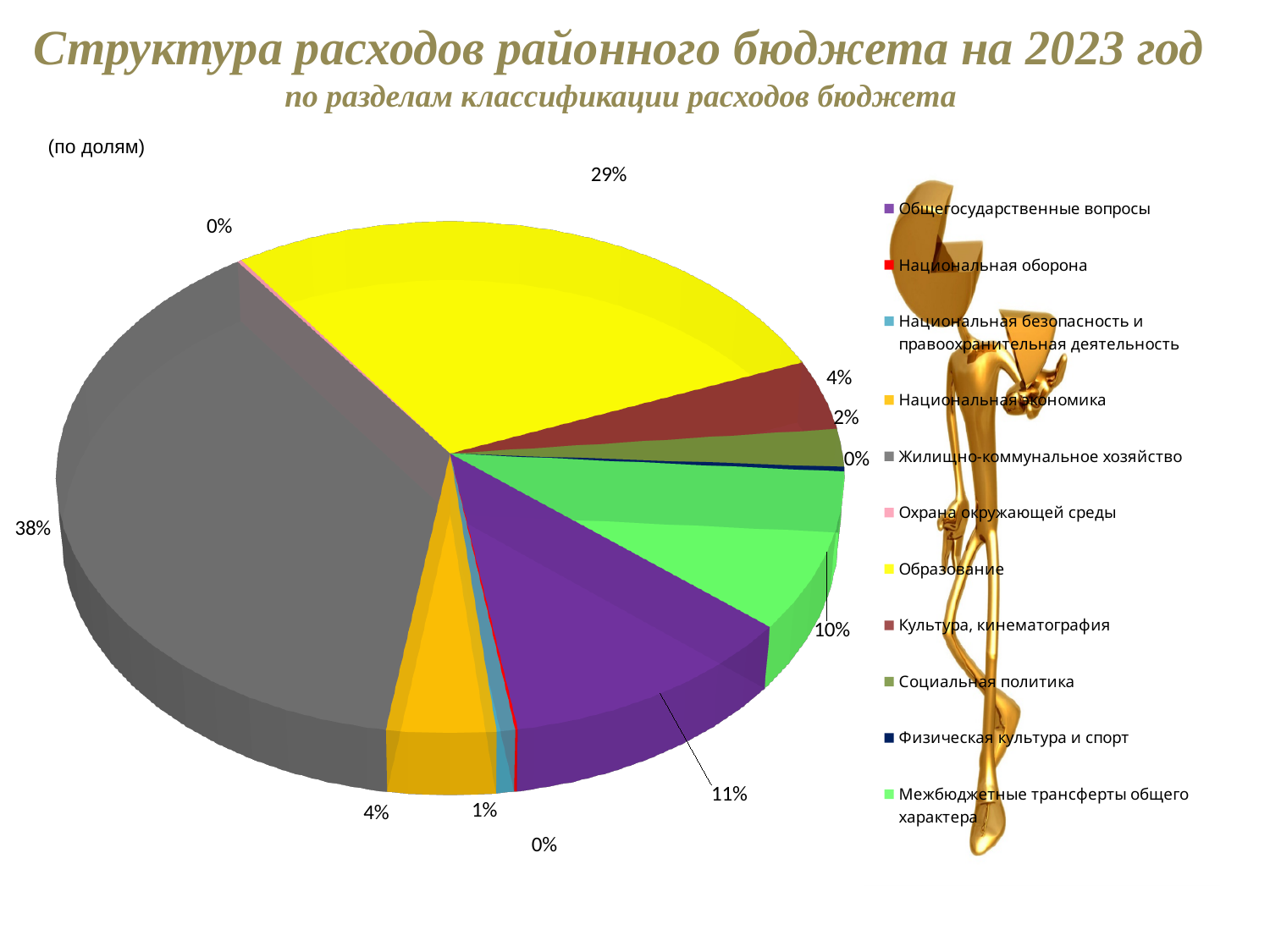
What is the difference between the share for Жилищно-коммунальное хозяйство and the share for Образование? 9% What share of the pie does Общегосударственные вопросы have? 11% How many categories does the legend list? 11 What share of the pie does Жилищно-коммунальное хозяйство have? 38% Which is larger, the share for Образование or the share for Общегосударственные вопросы? Образование Which category has the largest share of the pie? Жилищно-коммунальное хозяйство What is the title of the slide? Структура расходов районного бюджета на 2023 год What kind of chart is shown on the slide? Pie chart What share of the pie does Межбюджетные трансферты общего характера have? 10% What share of the pie does Образование have? 29% What share of the pie does Социальная политика have? 2% What share of the pie does Национальная безопасность и правоохранительная деятельность have? 1%